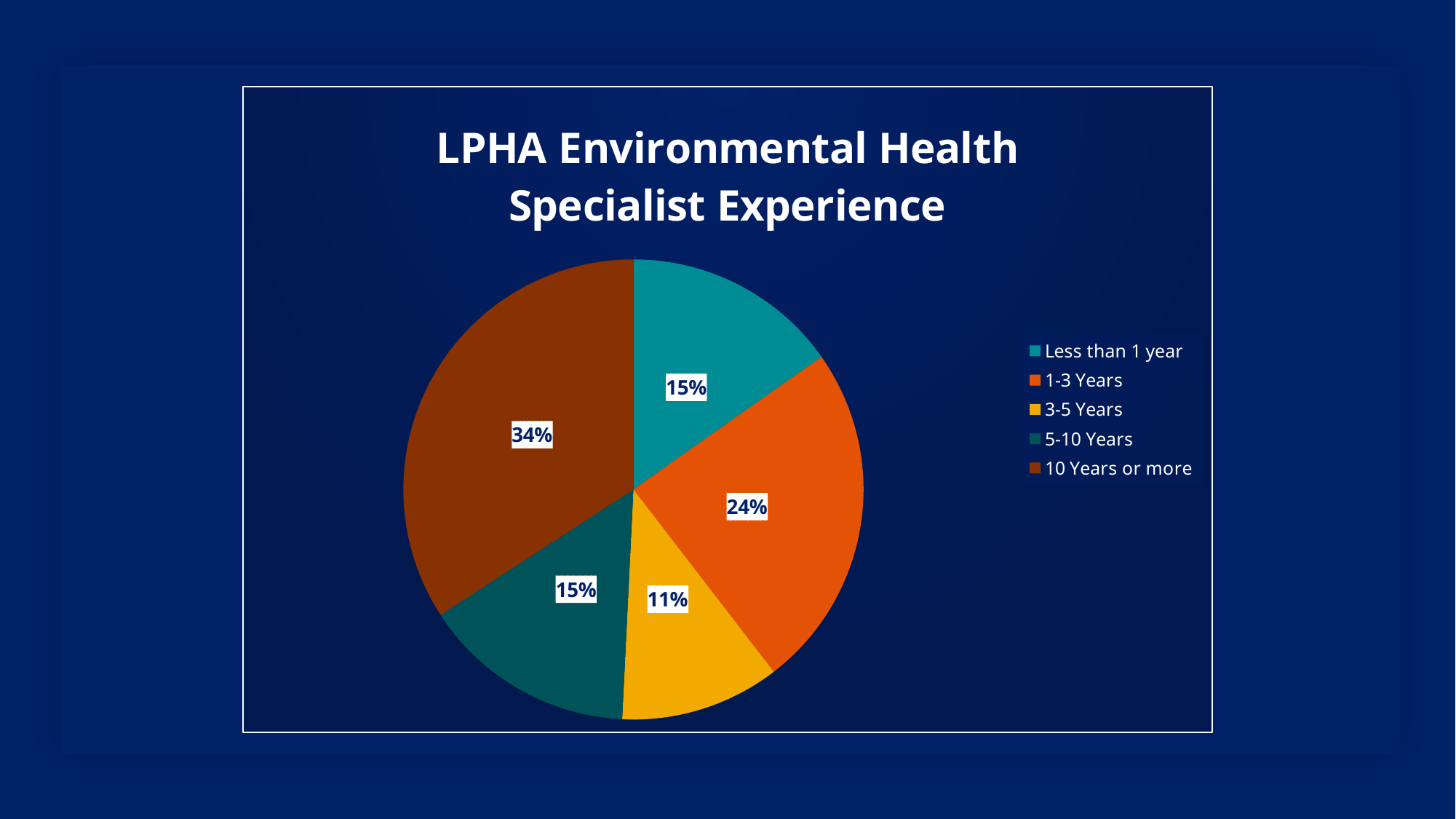
Which category has the smallest slice of the pie? 3-5 Years How many entries does the legend list? 5 What share of the pie is '1-3 Years'? 24% How many categories does the pie chart have? 5 What is the difference in percentage points between '10 Years or more' and '1-3 Years'? 10 Which is larger, the share for '1-3 Years' or the share for '5-10 Years'? 1-3 Years What share of the pie is '3-5 Years'? 11% Which category has the largest slice of the pie? 10 Years or more What is the title of the chart? LPHA Environmental Health Specialist Experience What share of the pie is 'Less than 1 year'? 15% What kind of chart is shown on the slide? pie chart